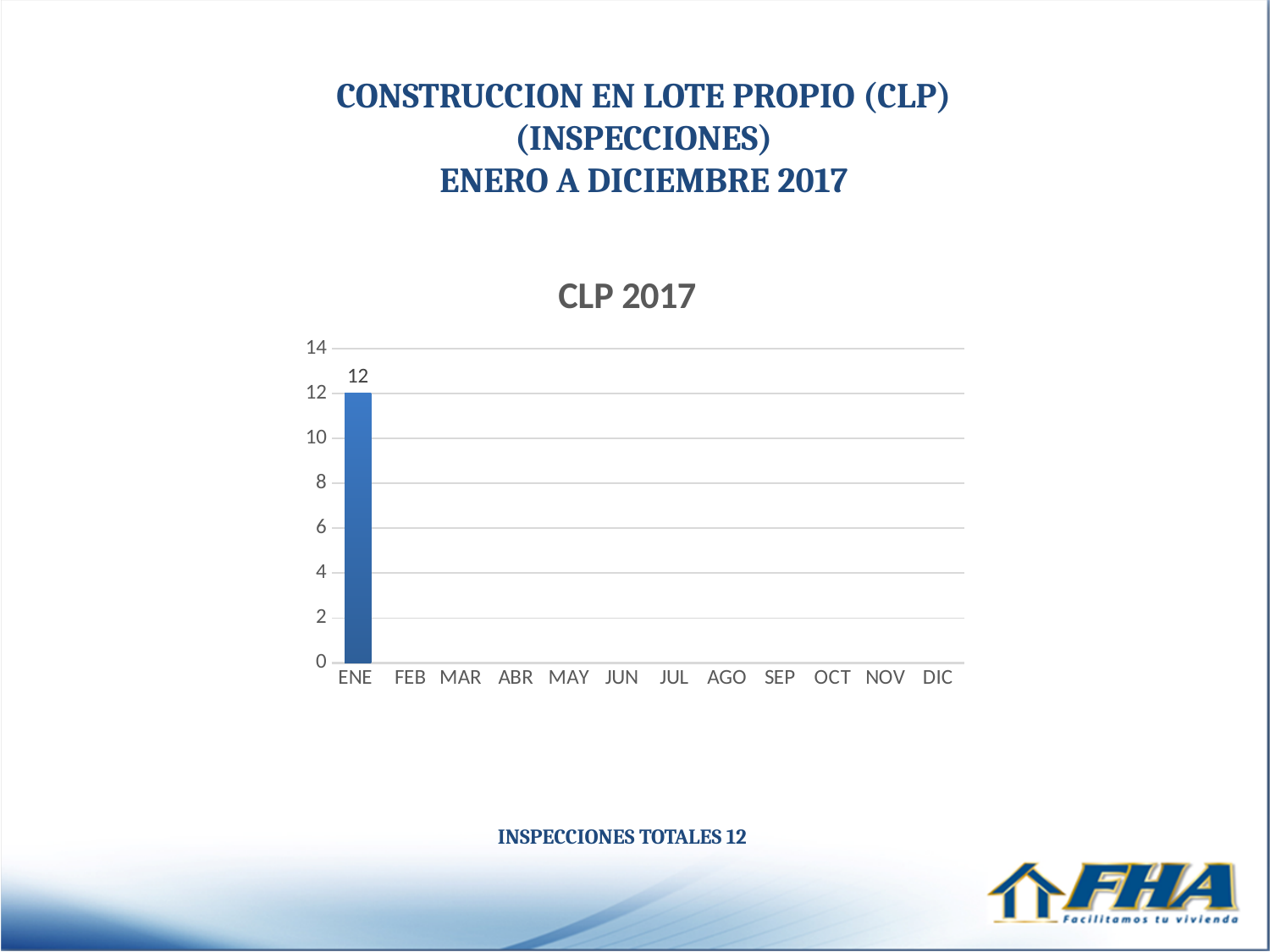
Is the value for ENE greater or less than 10? greater How many months in the CLP 2017 chart have a visible bar? 1 Is the value for ENE greater or less than 14? less Which month has the highest value in the CLP 2017 chart? ENE What kind of chart is the CLP 2017 chart? bar chart How many months are shown on the x axis of the CLP 2017 chart? 12 What is the value for ENE in the CLP 2017 chart? 12 What is the title of the chart? CLP 2017 What is the highest value shown on the y axis of the CLP 2017 chart? 14 What is the total number of inspections stated on the slide? 12